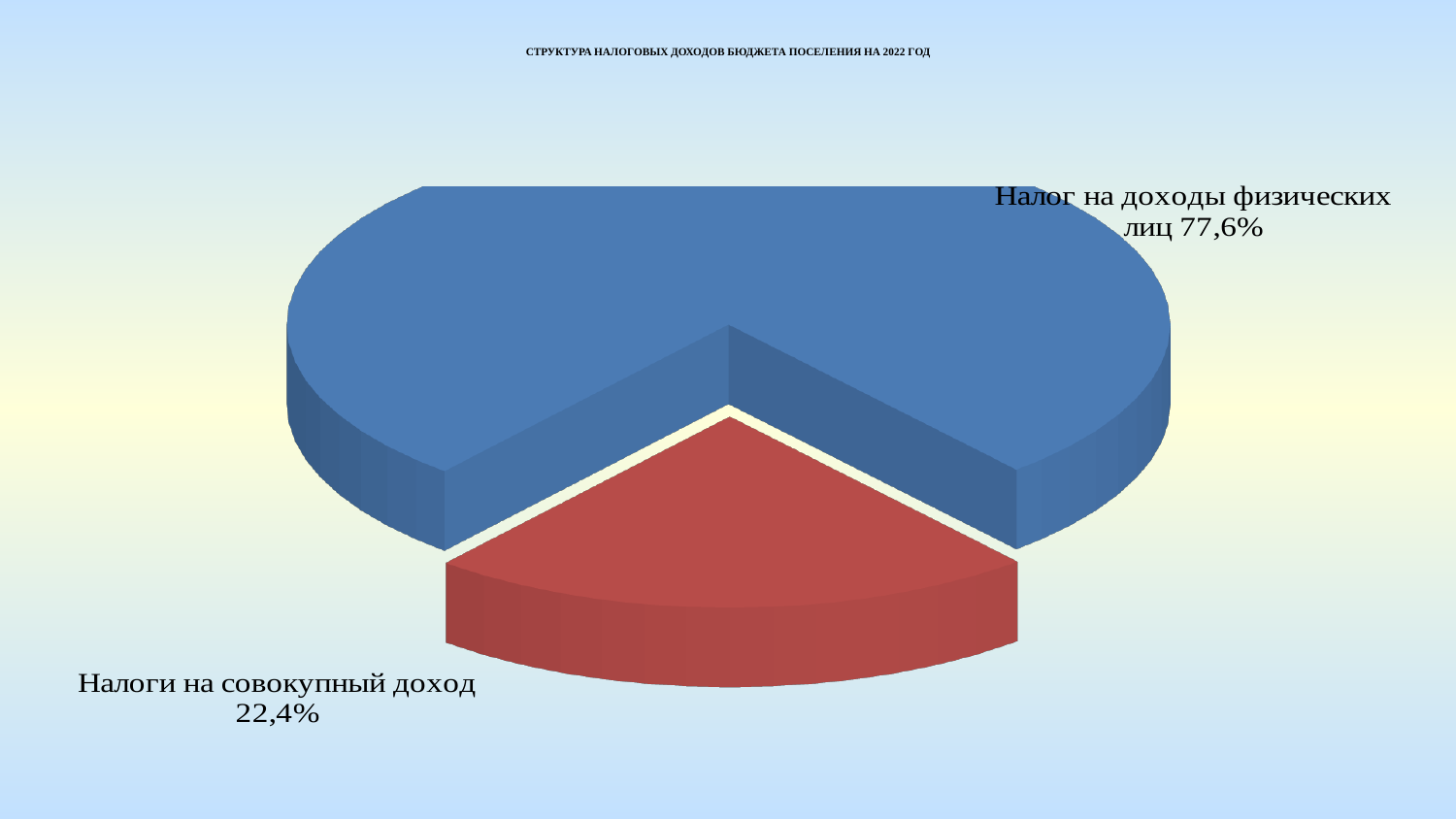
Which slice is the largest in the pie chart? Налог на доходы физических лиц What is the difference in percentage points between the share of "Налог на доходы физических лиц" and "Налоги на совокупный доход"? 55,2 What share of the pie does "Налоги на совокупный доход" represent? 22,4% What kind of chart is shown on the slide? Pie chart How many slices does the pie chart have? 2 What is the title of the chart? СТРУКТУРА НАЛОГОВЫХ ДОХОДОВ БЮДЖЕТА ПОСЕЛЕНИЯ НА 2022 ГОД What colour is the slice for "Налоги на совокупный доход"? Red What share of the pie does "Налог на доходы физических лиц" represent? 77,6% Which slice is the smallest in the pie chart? Налоги на совокупный доход Is the share of "Налог на доходы физических лиц" greater or less than 50%? greater Which is larger: the share of "Налог на доходы физических лиц" or "Налоги на совокупный доход"? Налог на доходы физических лиц